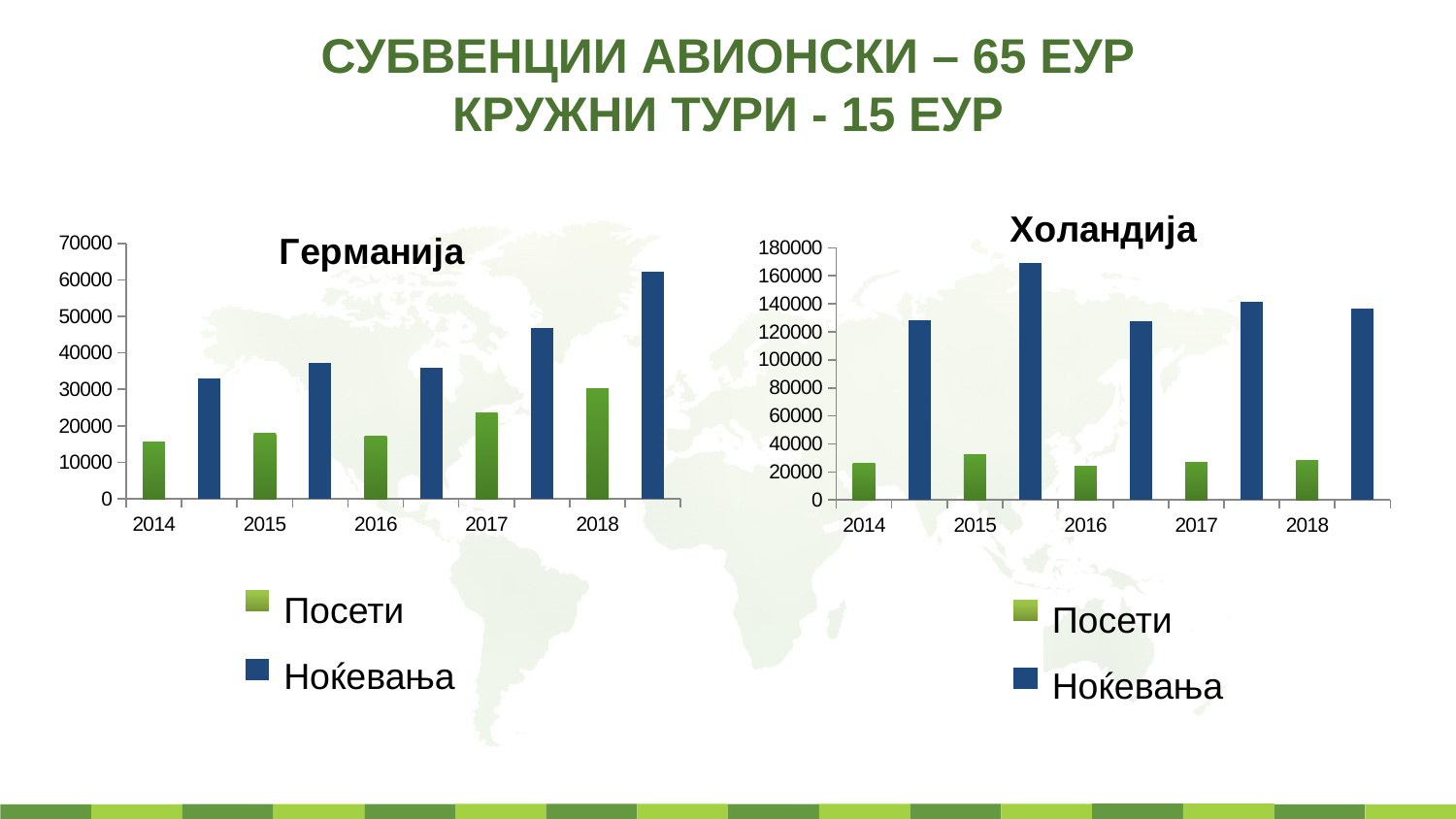
On the Германија chart, is the value for Ноќевања in 2018 greater or less than 60000? greater On the Холандија chart, which is larger: Ноќевања in 2014 or Ноќевања in 2017? 2017 On the Германија chart, do the Ноќевања values rise or fall from 2016 to 2018? rise On the Германија chart, which is larger: Ноќевања in 2016 or Ноќевања in 2017? 2017 On the Германија chart, is the value for Посети in 2014 greater or less than 20000? less On the Холандија chart, is the value for Посети in 2016 greater or less than 40000? less How many years are shown on the x axis of the Холандија chart? 5 On the Германија chart, which year has the highest value for Ноќевања? 2018 On the Холандија chart, which year has the highest value for Ноќевања? 2015 What kind of chart is the Германија chart? bar chart How many series does the legend of the Германија chart list? 2